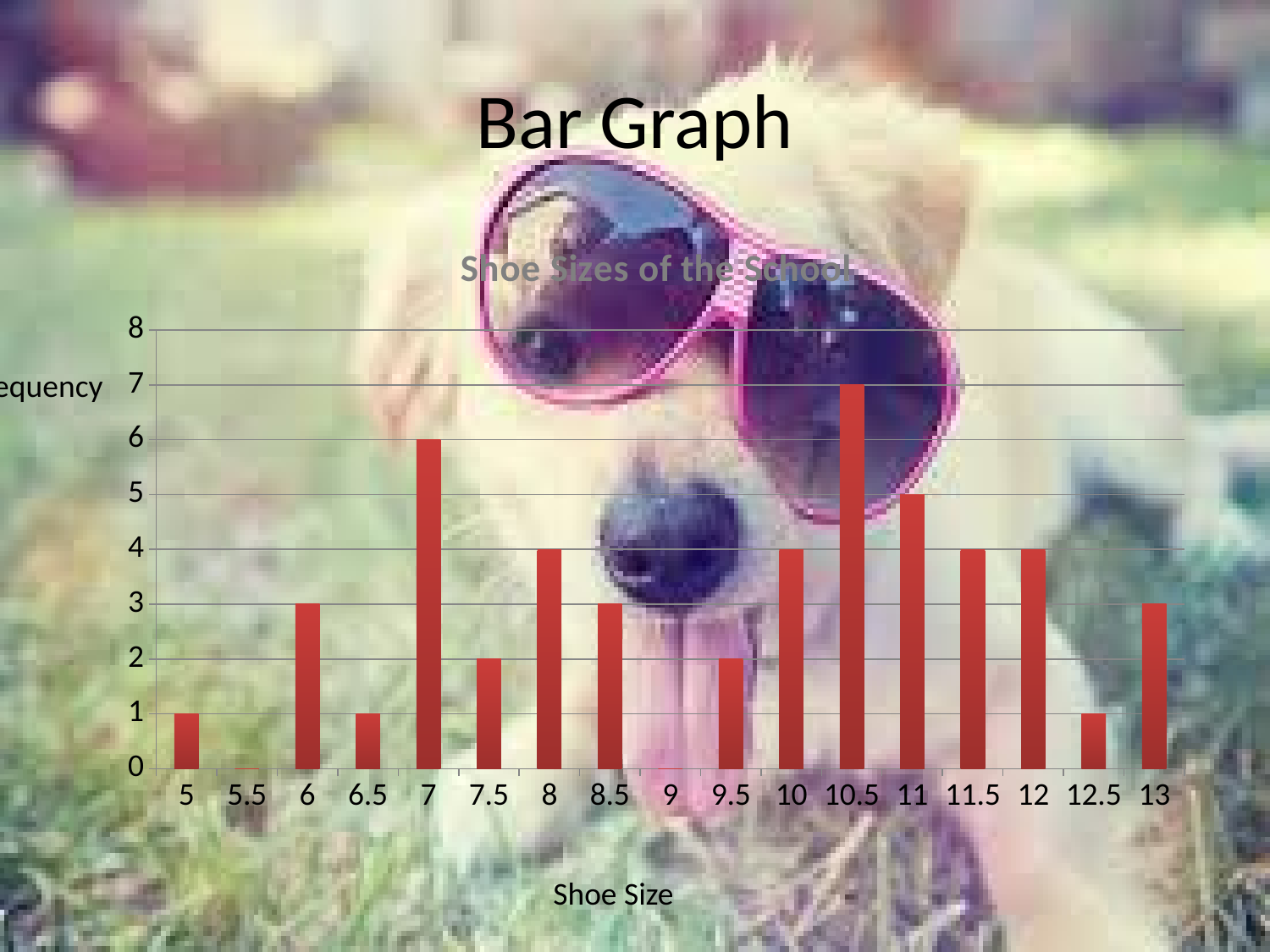
What is the frequency for shoe size 11? 5 Is the frequency for shoe size 11 greater or less than 4? greater What is the frequency for shoe size 7? 6 Which shoe size has the highest frequency? 10.5 What is the frequency for shoe size 12.5? 1 What label is shown on the x axis? Shoe Size What is the frequency for shoe size 10.5? 7 Which has a higher frequency, shoe size 6 or shoe size 8? 8 What type of chart is shown on the slide? bar chart What is the title of the chart? Shoe Sizes of the School How many shoe size categories are shown on the x axis? 17 What is the difference in frequency between shoe size 10.5 and shoe size 7? 1